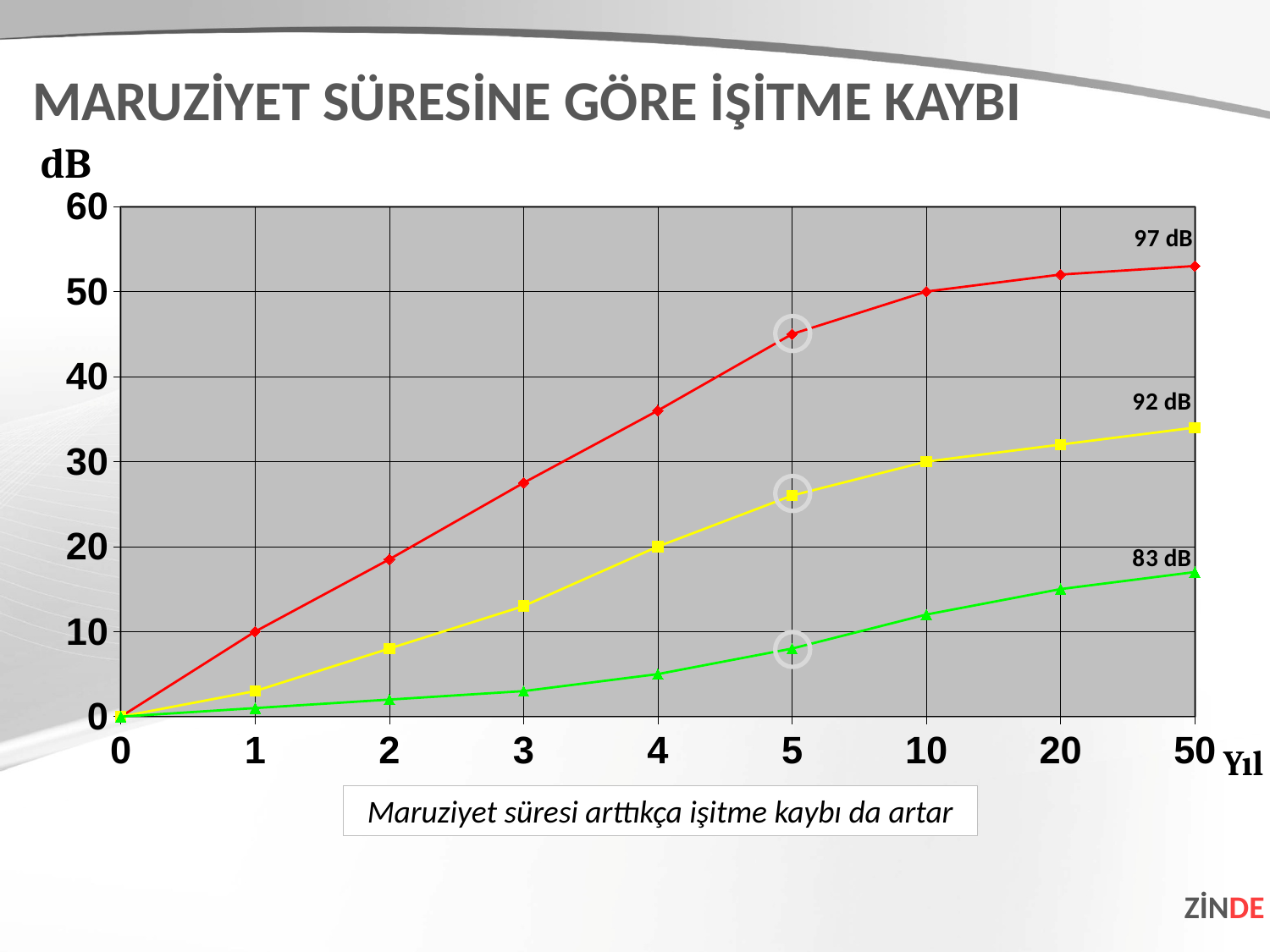
Is the value of the 83 dB series at 50 years greater or less than 20? less Do the values of the 83 dB series rise or fall as the years increase? rise How many points are marked along the x axis (Yıl)? 9 How many series are plotted on the chart? 3 Which series has the highest value at 50 years? 97 dB What kind of chart is shown on the slide? line chart What is the value of the 97 dB series at 1 year? 10 What is the value of the 97 dB series at 10 years? 50 What is the value of the 92 dB series at 10 years? 30 Is the value of the 97 dB series at 5 years greater or less than 40? greater What is the value of the 92 dB series at 4 years? 20 At 5 years, which series has the larger value, 92 dB or 83 dB? 92 dB